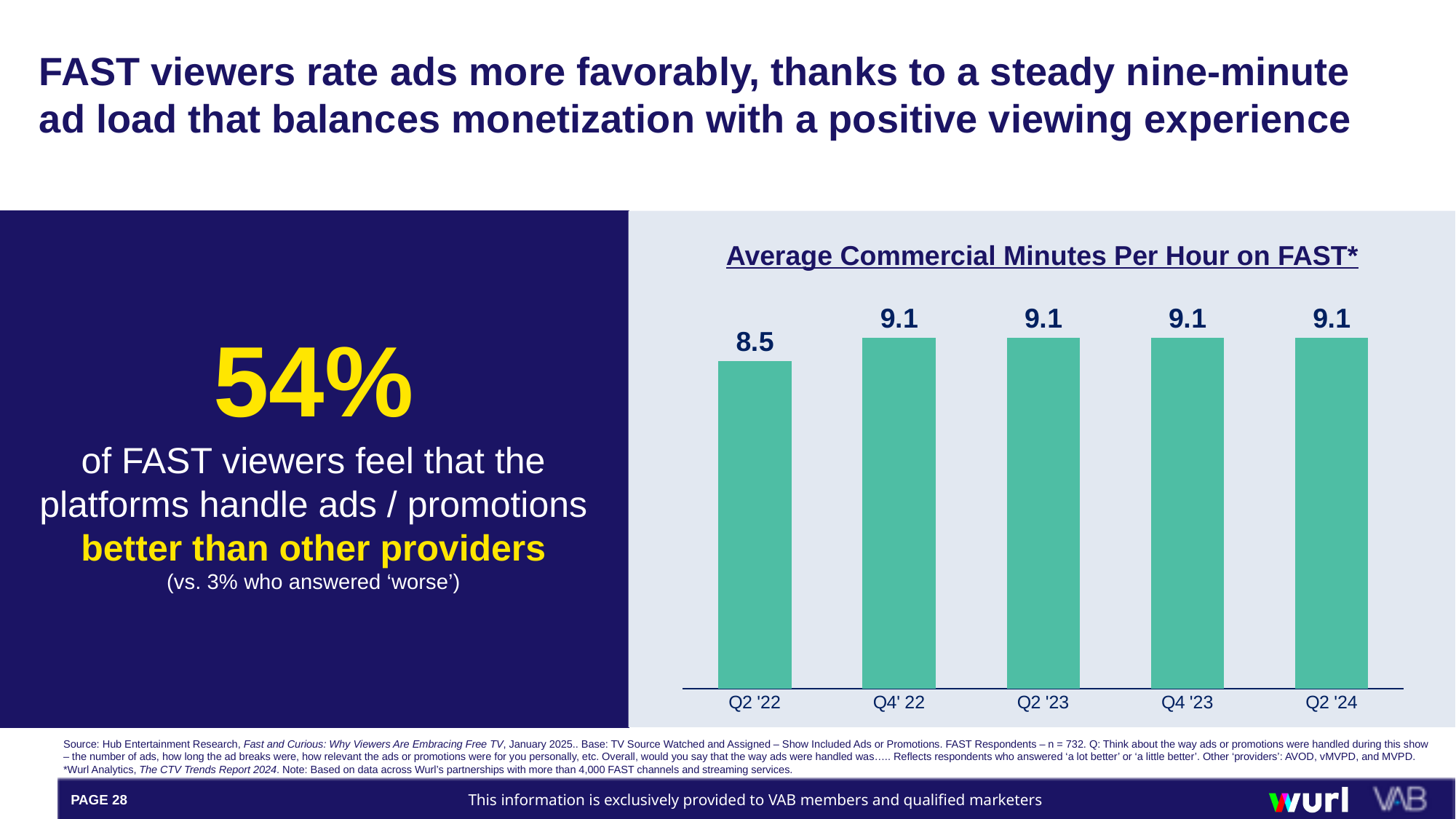
What is the average commercial minutes per hour on FAST for Q2 '24? 9.1 What is the difference between the values for Q4' 22 and Q2 '22? 0.6 Which is larger, the value for Q2 '22 or the value for Q2 '23? Q2 '23 How many quarters show a value of 9.1? 4 What is the average commercial minutes per hour on FAST for Q2 '22? 8.5 Which quarter has the lowest average commercial minutes per hour? Q2 '22 What is the title of the chart? Average Commercial Minutes Per Hour on FAST* What kind of chart is shown on the slide? Bar chart What colour are the bars in the chart? Green Do the values rise or fall from Q2 '22 to Q4' 22? Rise How many quarters are shown on the chart? 5 What is the value shown for Q4 '23? 9.1